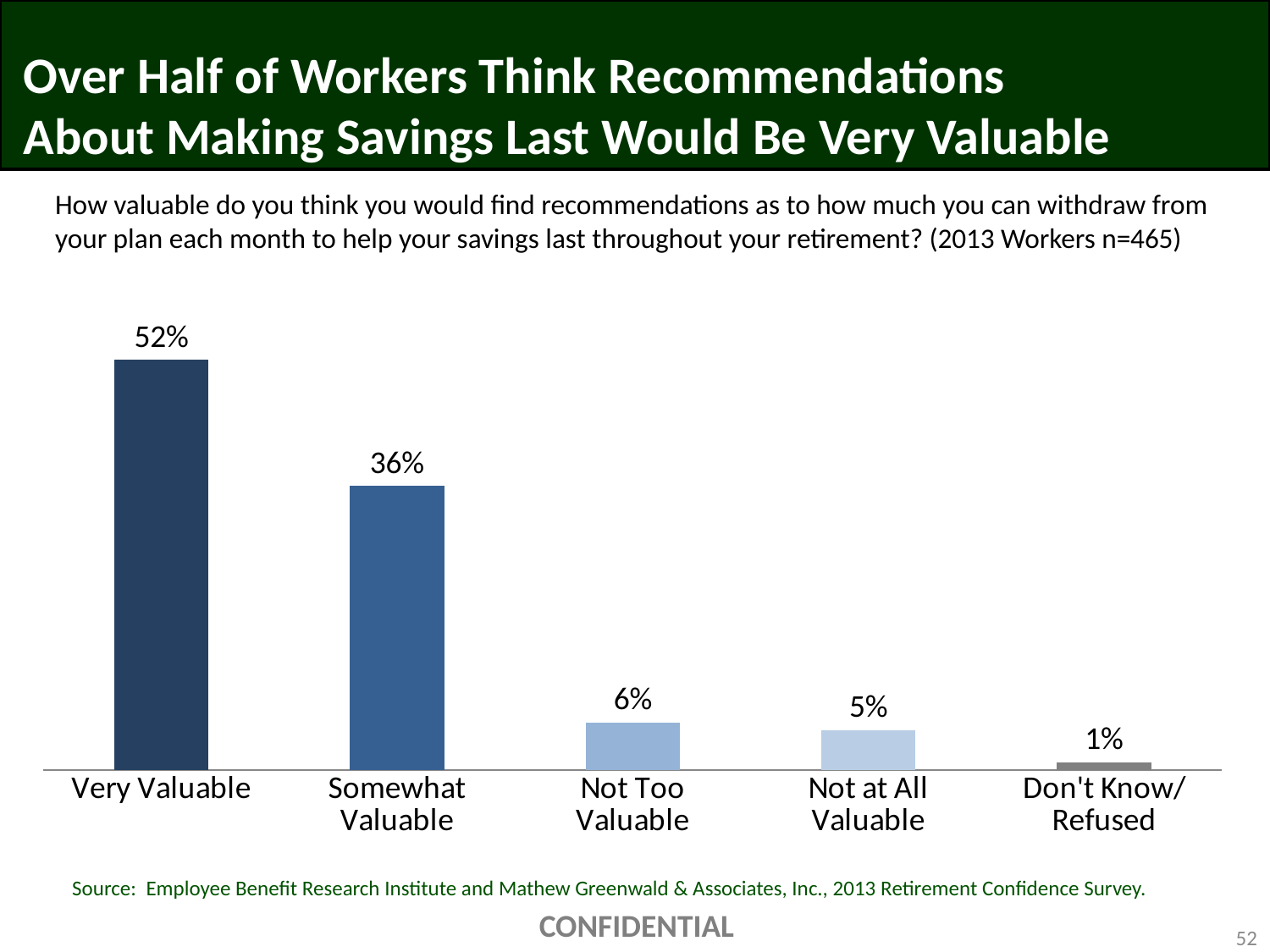
What percentage of workers said recommendations would be Very Valuable? 52% Which category has the highest value? Very Valuable What is the value for Somewhat Valuable? 36% What is the difference between the Not Too Valuable and Not at All Valuable values? 1% Which category has the lowest value? Don't Know/Refused What is the value for Not Too Valuable? 6% How many categories are shown in the chart? 5 Which is larger, the value for Somewhat Valuable or the value for Not at All Valuable? Somewhat Valuable What is the value for Don't Know/Refused? 1% What is the difference between the Very Valuable and Somewhat Valuable values? 16% Do the values rise or fall moving from left to right across the categories? Fall What kind of chart is shown on the slide? Bar chart